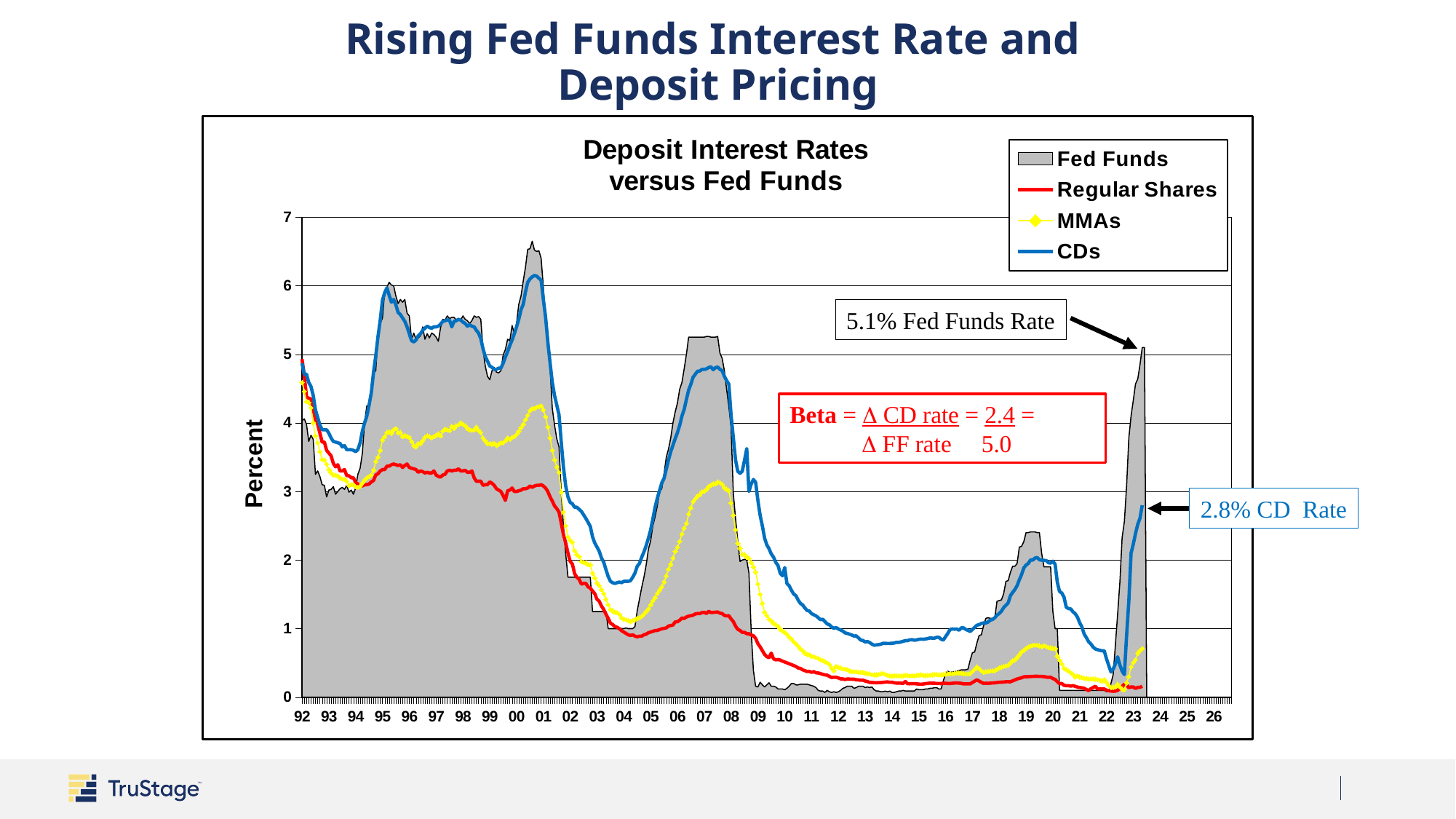
Does the Fed Funds series rise or fall between 2019 and 2021? fall How many series does the legend list? 4 In 2007, which is higher: the CDs series or the Regular Shares series? CDs What CD rate is called out in the annotation at the right of the chart? 2.8% What Beta value is shown in the red box on the chart? 2.4 / 5.0 Is the peak of the Fed Funds series around 2000-01 greater or less than 6? greater Is the value of the CDs series in 2014 greater or less than 1? less Is the value of the Fed Funds series in 2010 greater or less than 1? less Which series has the highest value at the right end of the chart (2023)? Fed Funds What is the difference between the annotated 5.1% Fed Funds rate and the annotated 2.8% CD rate? 2.3% What is the title of the chart? Deposit Interest Rates versus Fed Funds What Fed Funds rate is called out in the annotation at the right of the chart? 5.1%